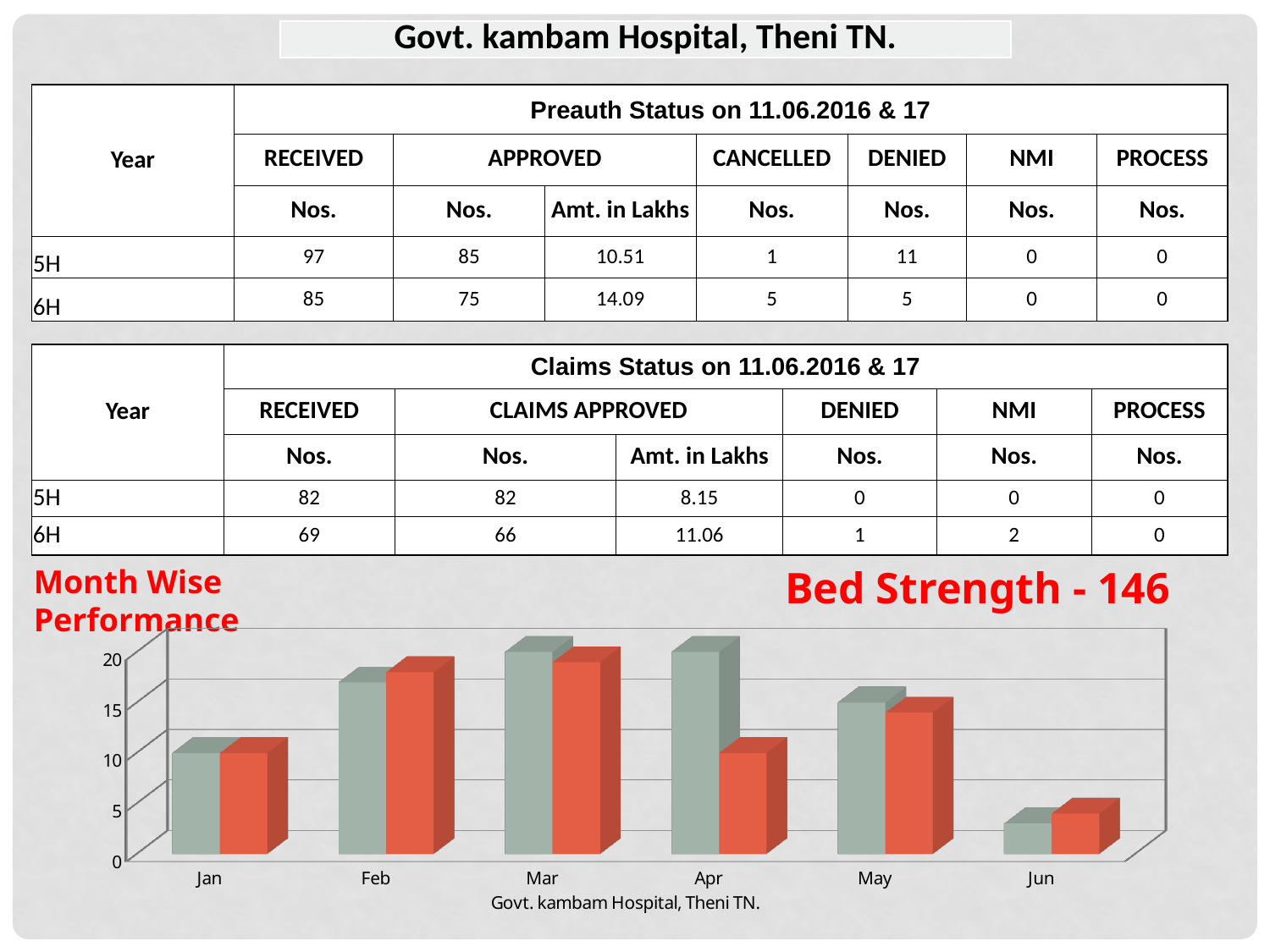
In the Month Wise Performance chart, do the grey (left) bars rise or fall from Apr to Jun? fall In the Month Wise Performance chart, is the red (right) bar for Jan greater or less than 15? less What kind of chart is shown under the heading 'Month Wise Performance'? bar chart In the Month Wise Performance chart, which month has the lowest grey (left) bar? Jun In the Month Wise Performance chart, which month has the lowest red (right) bar? Jun In the Month Wise Performance chart, is the grey (left) bar for Apr greater or less than 15? greater In the Month Wise Performance chart, is the red (right) bar for Apr greater or less than 15? less In the Month Wise Performance chart, for Apr, which bar is taller: the grey (left) bar or the red (right) bar? the grey (left) bar What text appears below the month labels on the x axis of the Month Wise Performance chart? Govt. kambam Hospital, Theni TN. How many months are shown on the x axis of the Month Wise Performance chart? 6